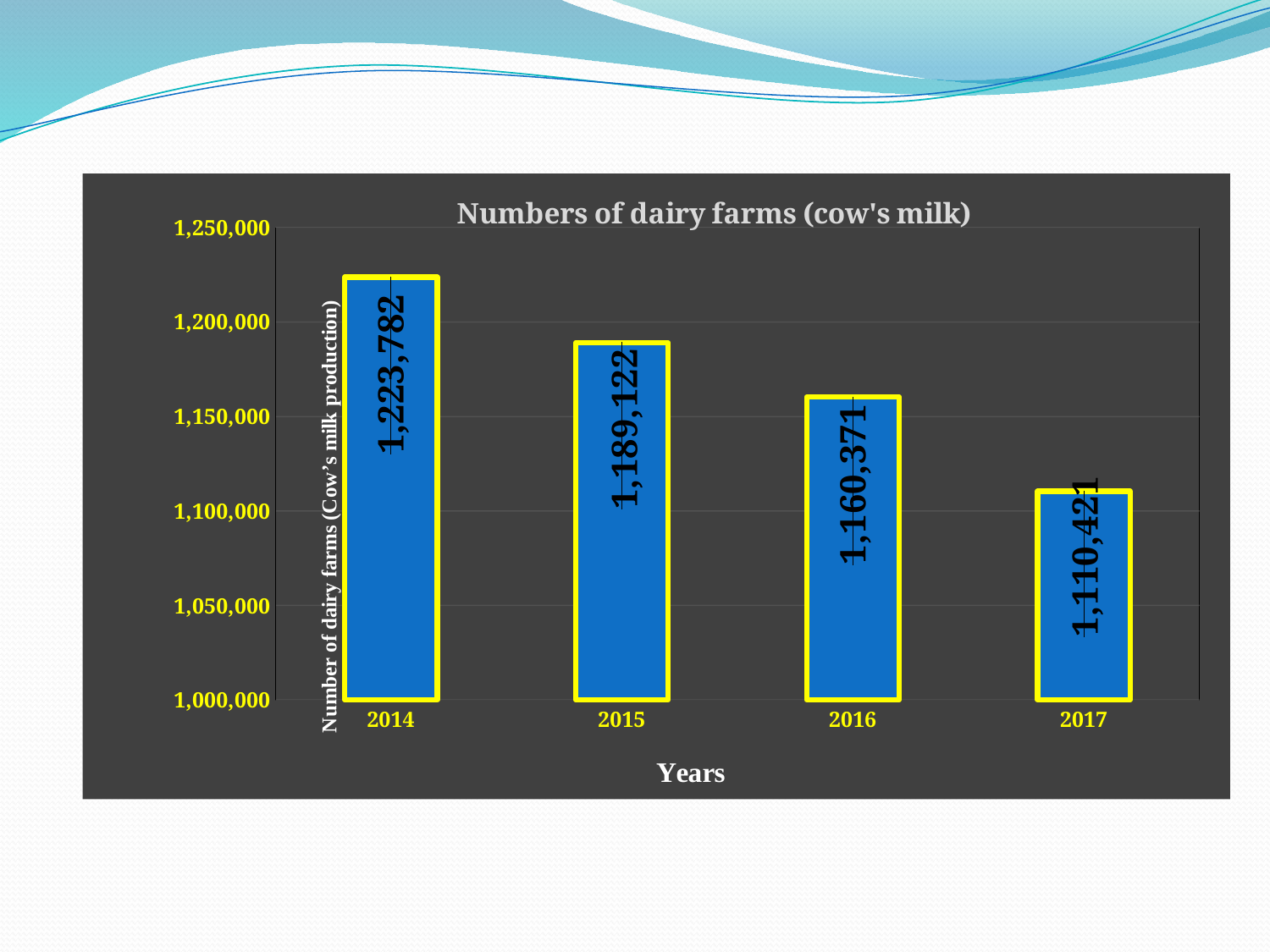
What is the value for 2014? 1,223,782 Which year has the lowest number of dairy farms? 2017 What is the difference between the values for 2014 and 2015? 34,660 Which year has the highest number of dairy farms? 2014 What is the value for 2016? 1,160,371 Which is larger, the value for 2015 or the value for 2016? 2015 What is the difference between the values for 2016 and 2017? 49,950 Is the value for 2017 greater or less than 1,150,000? less What is the value for 2015? 1,189,122 What kind of chart is this? bar chart How many years are shown on the x axis? 4 What is the value for 2017? 1,110,421